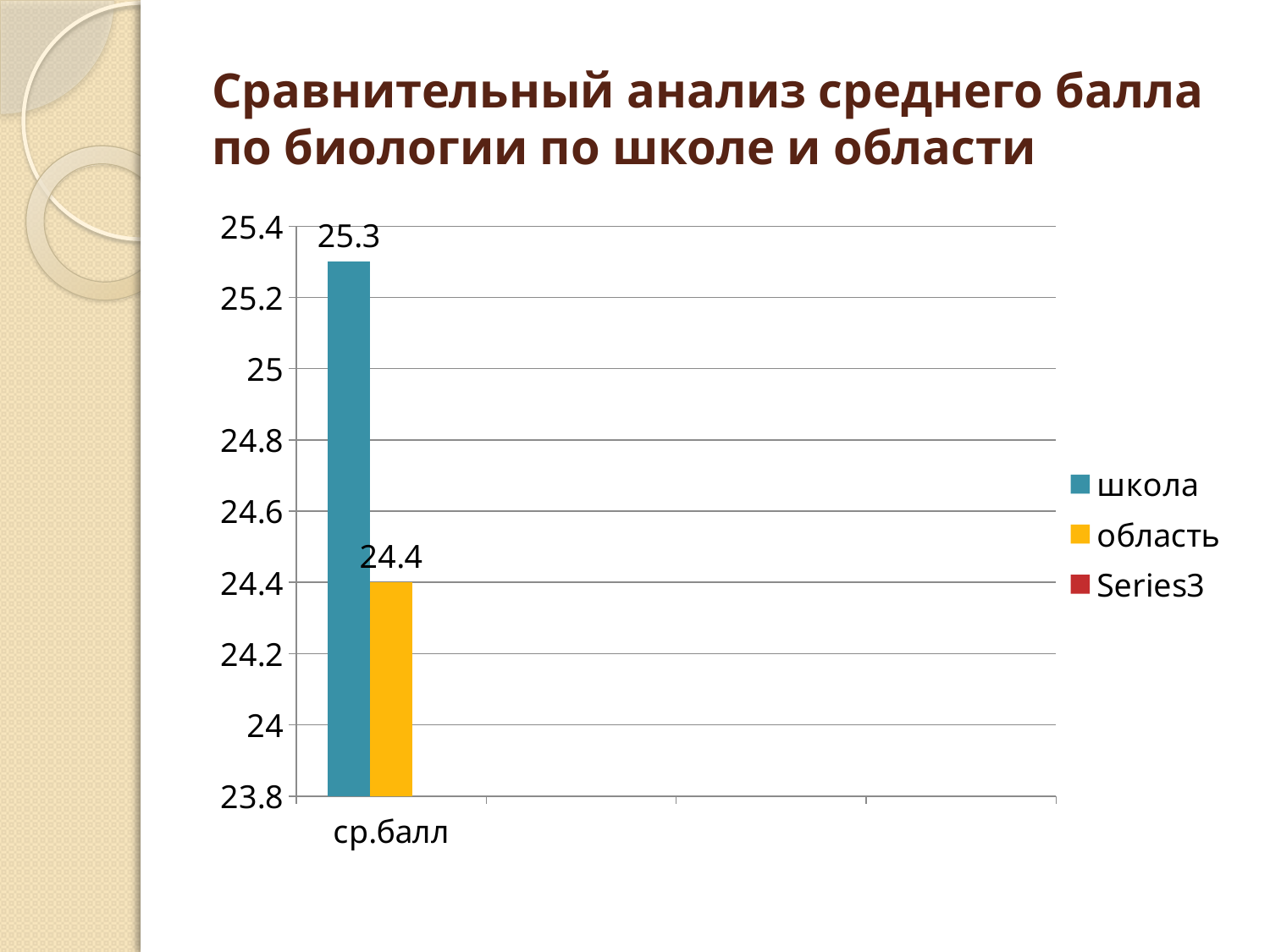
Which series has the lowest plotted value? область Which series has the higher value for ср.балл, школа or область? школа What kind of chart is shown on the slide? bar chart What colour is the bar for область? yellow What is the difference between the школа and область values for ср.балл? 0.9 What is the value for школа in the ср.балл category? 25.3 Is the value for школа greater or less than 25? greater How many categories are shown on the x axis? 1 What is the value for область in the ср.балл category? 24.4 What is the label of the category on the x axis? ср.балл Is the value for область greater or less than 25? less How many series does the legend list? 3